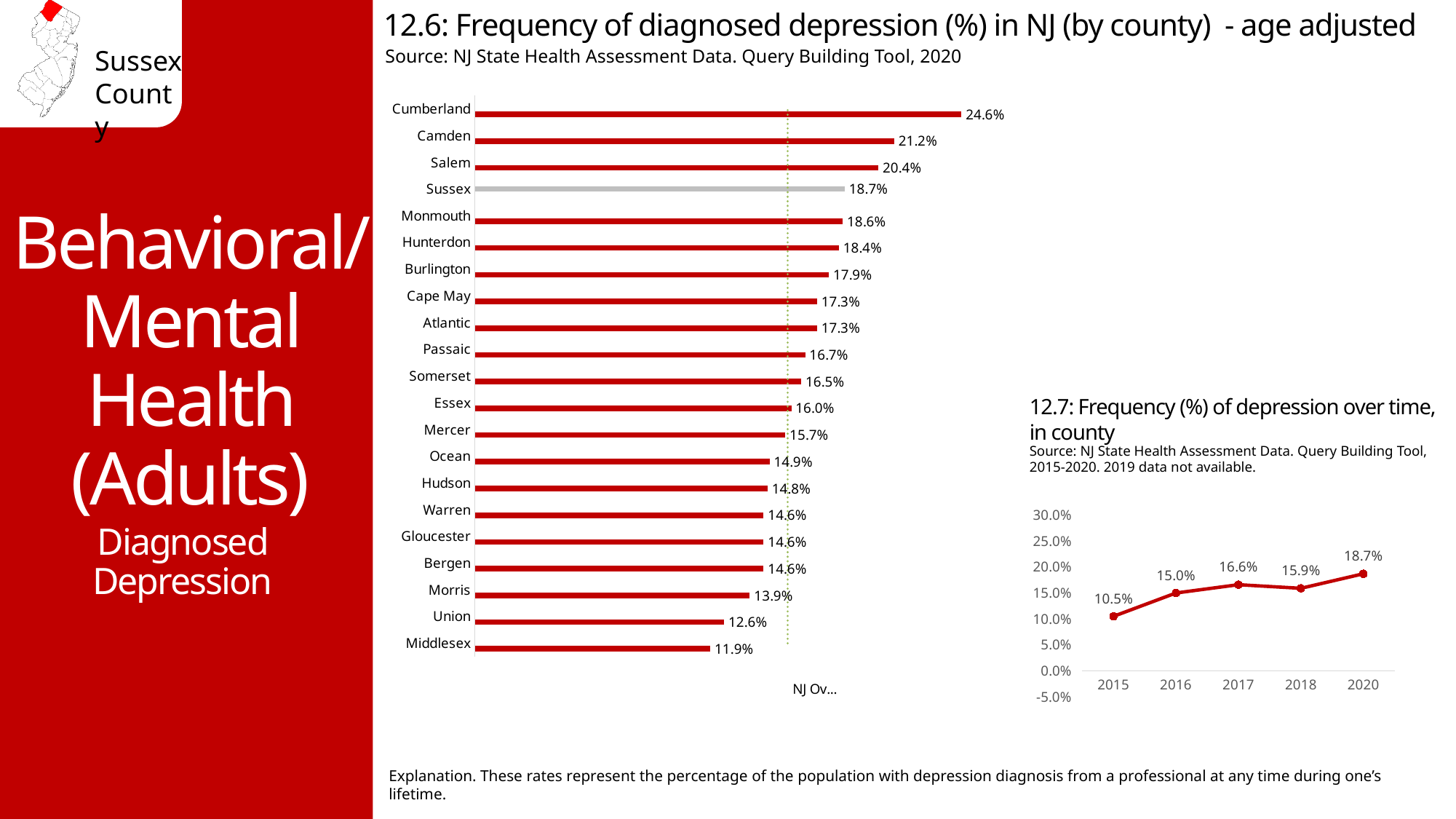
What kind of chart is '12.7: Frequency (%) of depression over time, in county'? Line chart What kind of chart is '12.6: Frequency of diagnosed depression (%) in NJ (by county) - age adjusted'? Bar chart In the chart '12.6: Frequency of diagnosed depression (%) in NJ (by county) - age adjusted', which county has the highest value? Cumberland In the chart '12.7: Frequency (%) of depression over time, in county', what is the value for 2015? 10.5% In the chart '12.6: Frequency of diagnosed depression (%) in NJ (by county) - age adjusted', which is larger, Salem or Monmouth? Salem In the chart '12.7: Frequency (%) of depression over time, in county', which year has the highest value? 2020 In the chart '12.6: Frequency of diagnosed depression (%) in NJ (by county) - age adjusted', which county has the lowest value? Middlesex In the chart '12.6: Frequency of diagnosed depression (%) in NJ (by county) - age adjusted', how many counties are shown? 21 In the chart '12.6: Frequency of diagnosed depression (%) in NJ (by county) - age adjusted', what is the difference between Cumberland and Middlesex? 12.7% In the chart '12.6: Frequency of diagnosed depression (%) in NJ (by county) - age adjusted', what is the value for Sussex? 18.7% In the chart '12.6: Frequency of diagnosed depression (%) in NJ (by county) - age adjusted', what is the value for Camden? 21.2% In the chart '12.7: Frequency (%) of depression over time, in county', what is the difference between 2020 and 2015? 8.2%